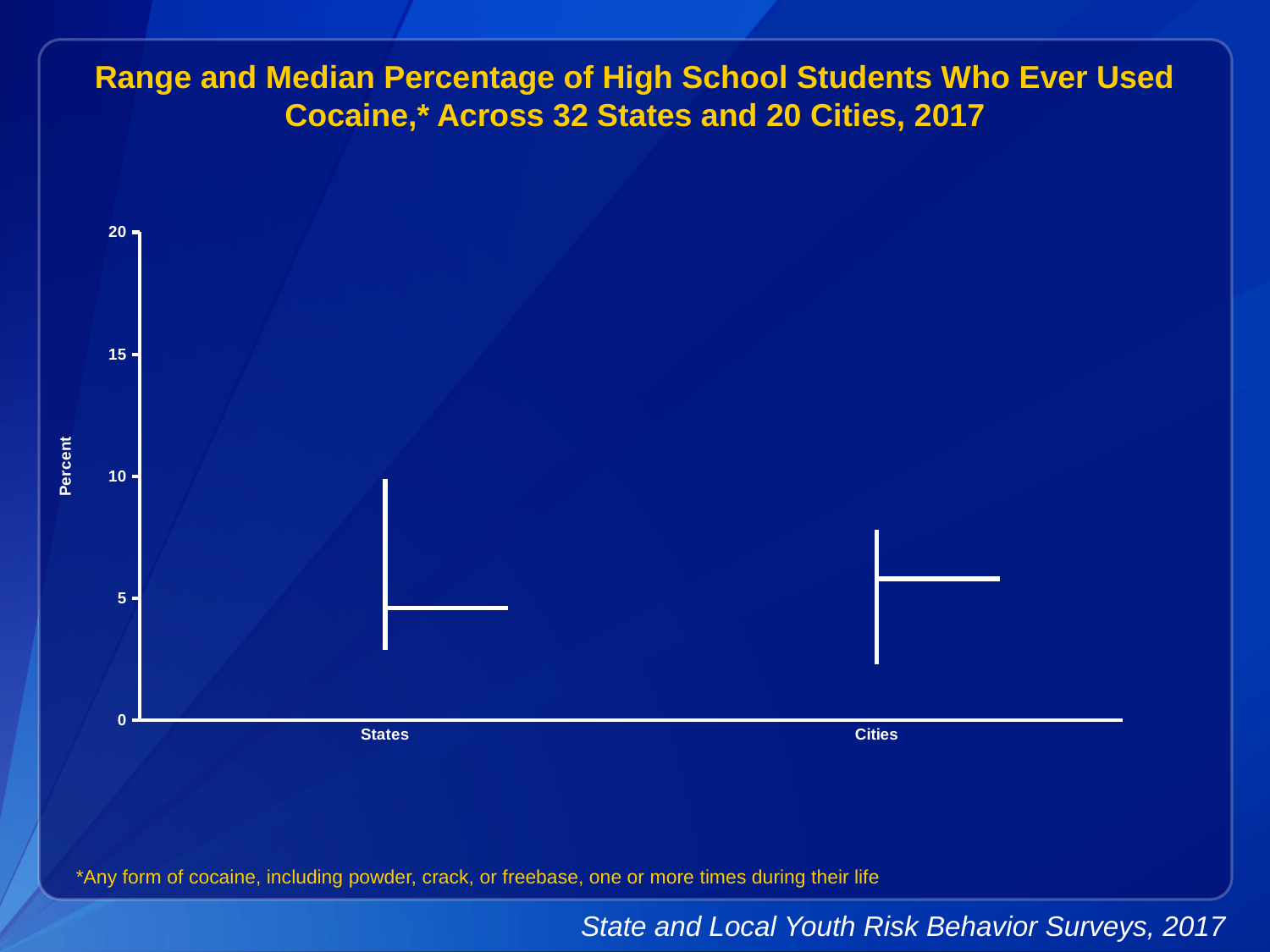
Is the bottom of the range for States greater or less than 5? less Is the median value for Cities greater or less than 5? greater Is the top of the range for States greater or less than 5? greater Which category has the higher median value, States or Cities? Cities What is the label of the vertical axis? Percent What is the highest value shown on the vertical axis? 20 Which category has the higher top of its range, States or Cities? States How many categories are shown on the x axis of the chart? 2 What are the two categories shown on the x axis? States and Cities